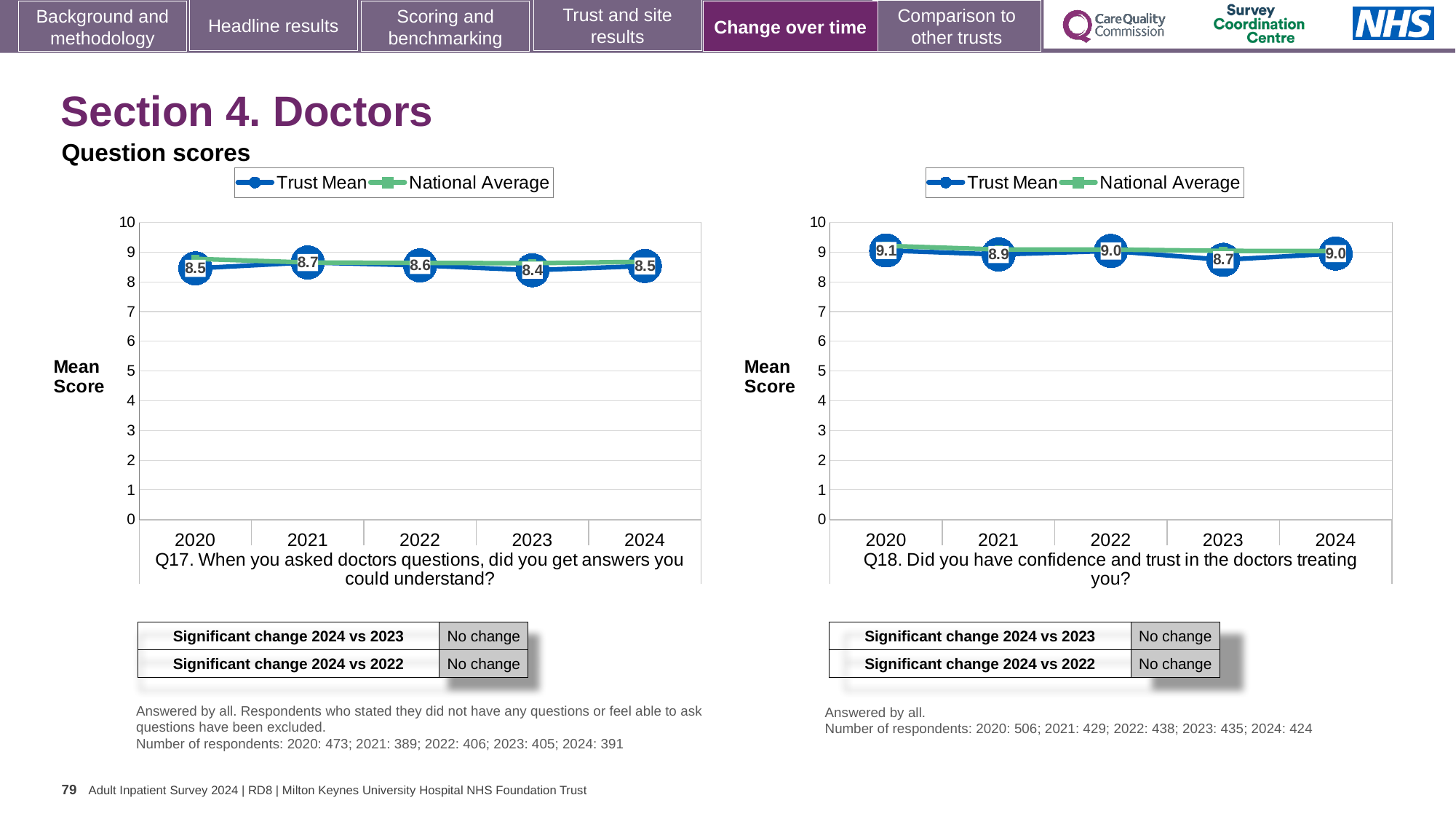
How many series does the legend of the Q18 chart list? 2 In the Q18 chart, which year has the lowest Trust Mean score? 2023 In the Q17 chart, what is the Trust Mean score for 2021? 8.7 How many years are plotted on the x axis of the Q17 chart? 5 What kind of chart is the Q18 chart? Line chart In the Q17 chart, is the Trust Mean score for 2022 greater or less than 8? greater In the Q18 chart, what is the difference between the Trust Mean scores for 2020 and 2023? 0.4 In the Q17 chart, what is the Trust Mean score for 2023? 8.4 In the Q18 chart, which series is shown in blue? Trust Mean In the Q18 chart, what is the Trust Mean score for 2020? 9.1 In the Q17 chart, which year has the highest Trust Mean score? 2021 In the Q18 chart, what is the Trust Mean score for 2023? 8.7